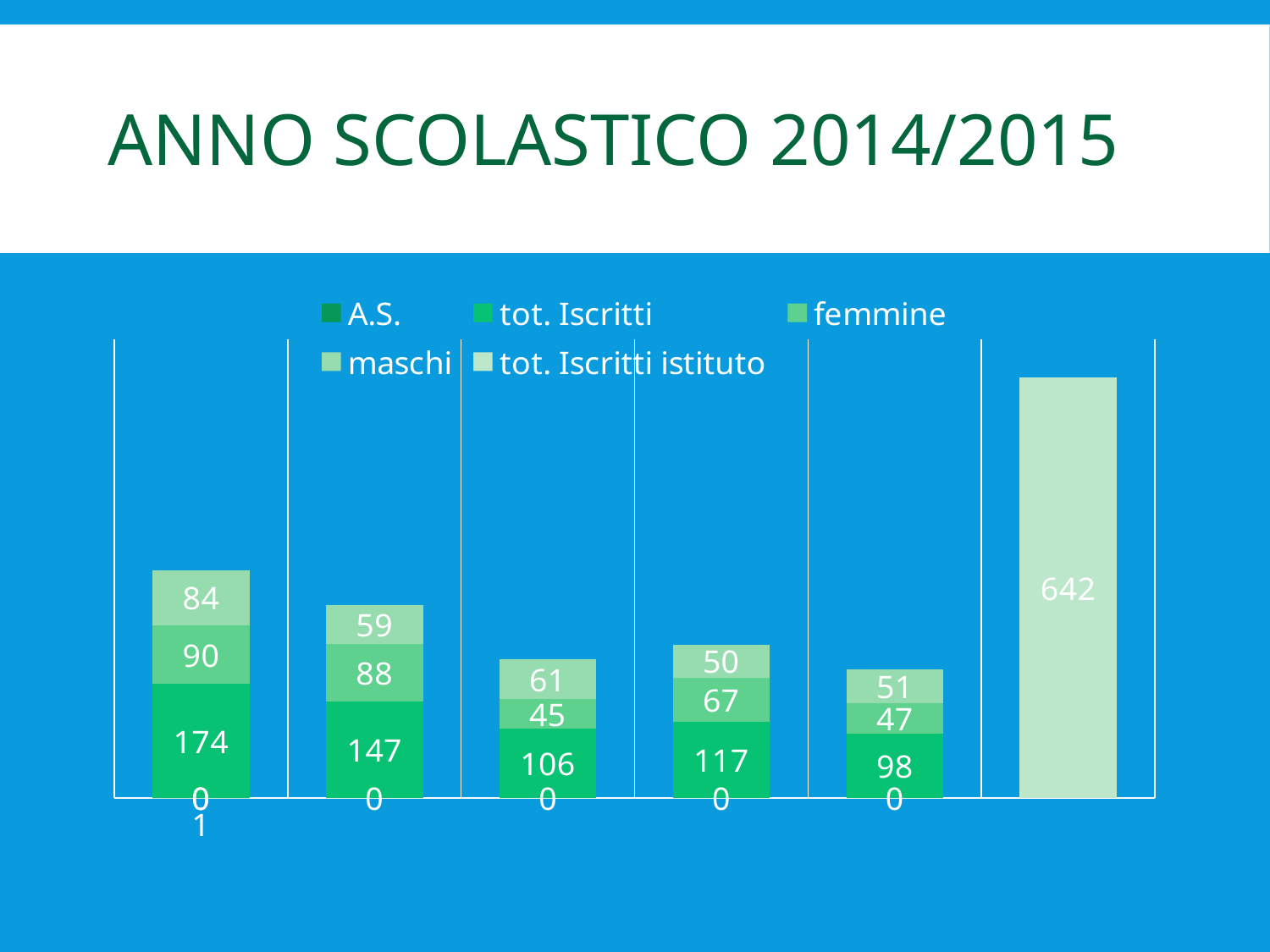
What is the total of the first (leftmost) stacked bar? 348 Which stacked bar has the highest tot. Iscritti value? the first (leftmost) bar, 174 What is the tot. Iscritti value in the first (leftmost) stacked bar? 174 Which stacked bar has the lowest tot. Iscritti value? the fifth bar, 98 What is the difference between the tot. Iscritti values of the first and second stacked bars? 27 What is the title of the slide containing the chart? ANNO SCOLASTICO 2014/2015 What is the maschi value in the third stacked bar from the left? 61 How many series does the legend list? 5 What kind of chart is shown on the slide? stacked bar chart How many bars are plotted in the chart? 6 In the first (leftmost) stacked bar, which is larger: femmine or maschi? femmine What is the value of the tot. Iscritti istituto bar (the rightmost bar)? 642